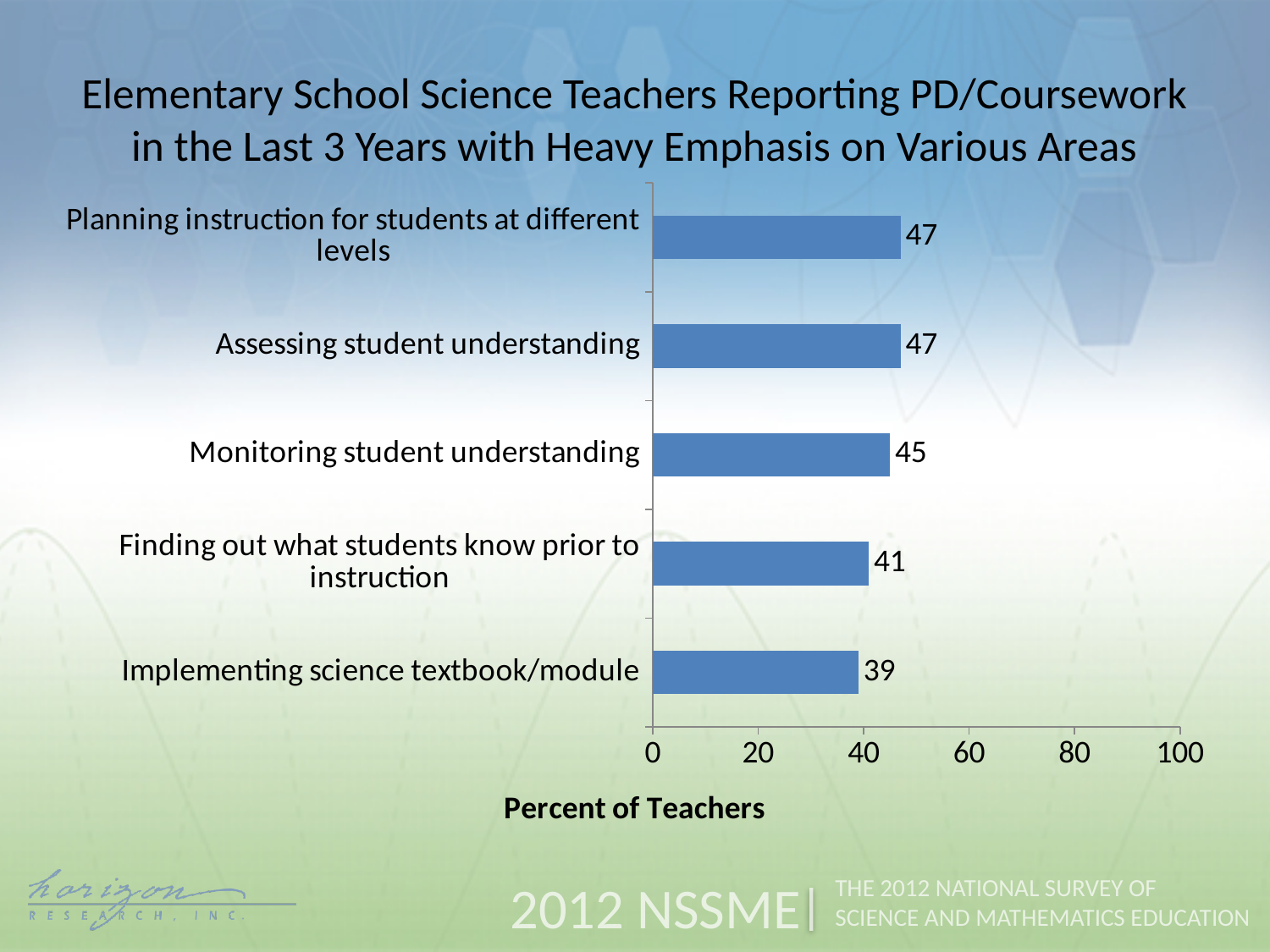
What is the label of the horizontal axis? Percent of Teachers How many categories are shown in the chart? 5 What is the value for Finding out what students know prior to instruction? 41 What is the value for Implementing science textbook/module? 39 What is the difference between the values for Assessing student understanding and Finding out what students know prior to instruction? 6 What is the difference between the values for Monitoring student understanding and Implementing science textbook/module? 6 What kind of chart is shown on the slide? bar chart Which is larger: the value for Monitoring student understanding or the value for Implementing science textbook/module? Monitoring student understanding Which category has the lowest value? Implementing science textbook/module Is the value for Finding out what students know prior to instruction greater or less than 60? less What percent of teachers reported heavy emphasis on Assessing student understanding? 47 What is the value for Monitoring student understanding? 45